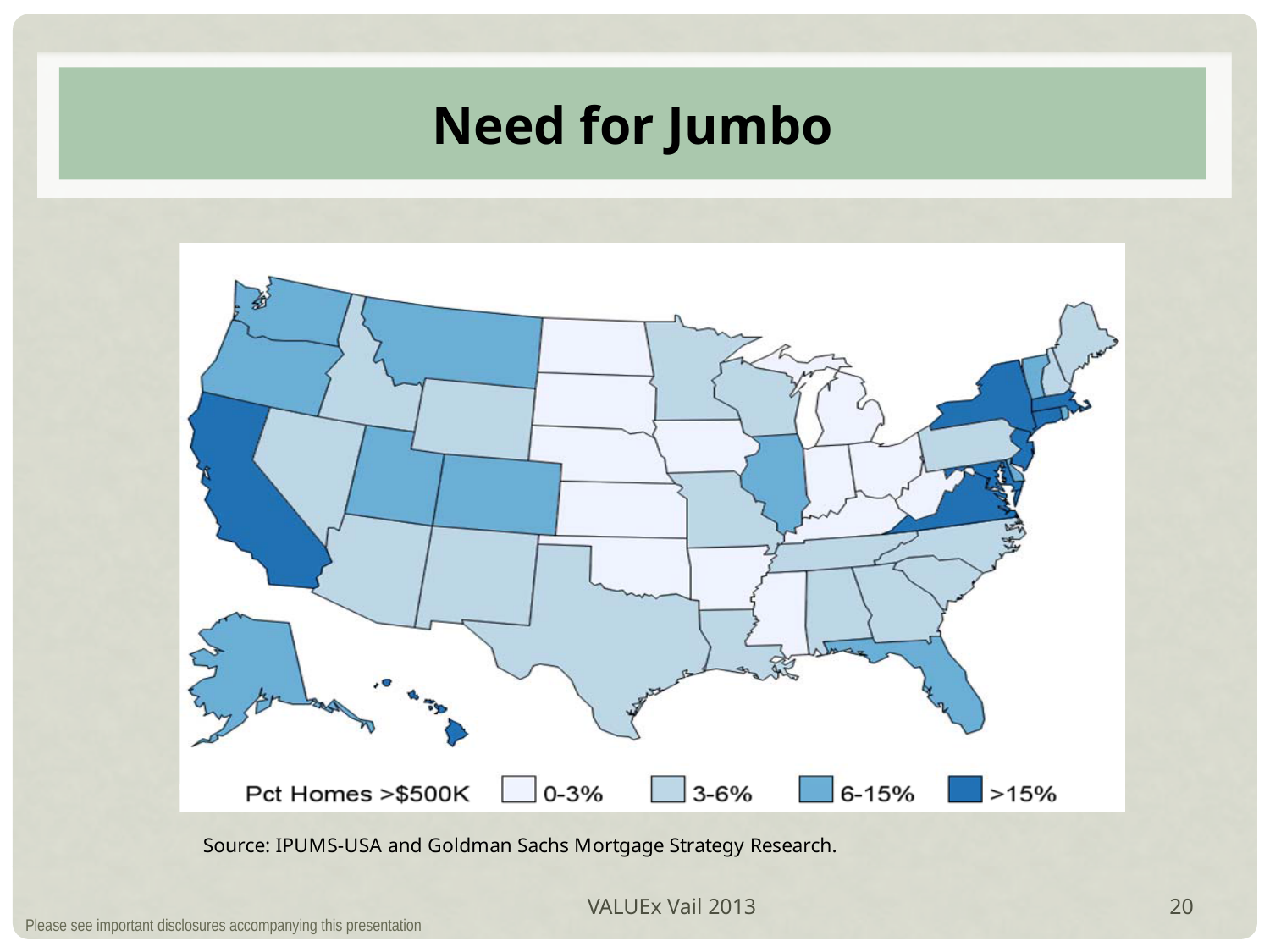
What is the title of the slide containing the map? Need for Jumbo What measure does the map legend say the shading represents? Pct Homes >$500K Which legend range is shaded with the darkest blue? >15% What legend range lies between 3-6% and >15%? 6-15% What kind of chart is shown on the slide? Map (choropleth map of the United States) What is the lowest range shown in the map legend? 0-3% What is the highest range shown in the map legend? >15% How many shading categories does the map legend list? 4 Which legend range is shaded with the lightest colour? 0-3%